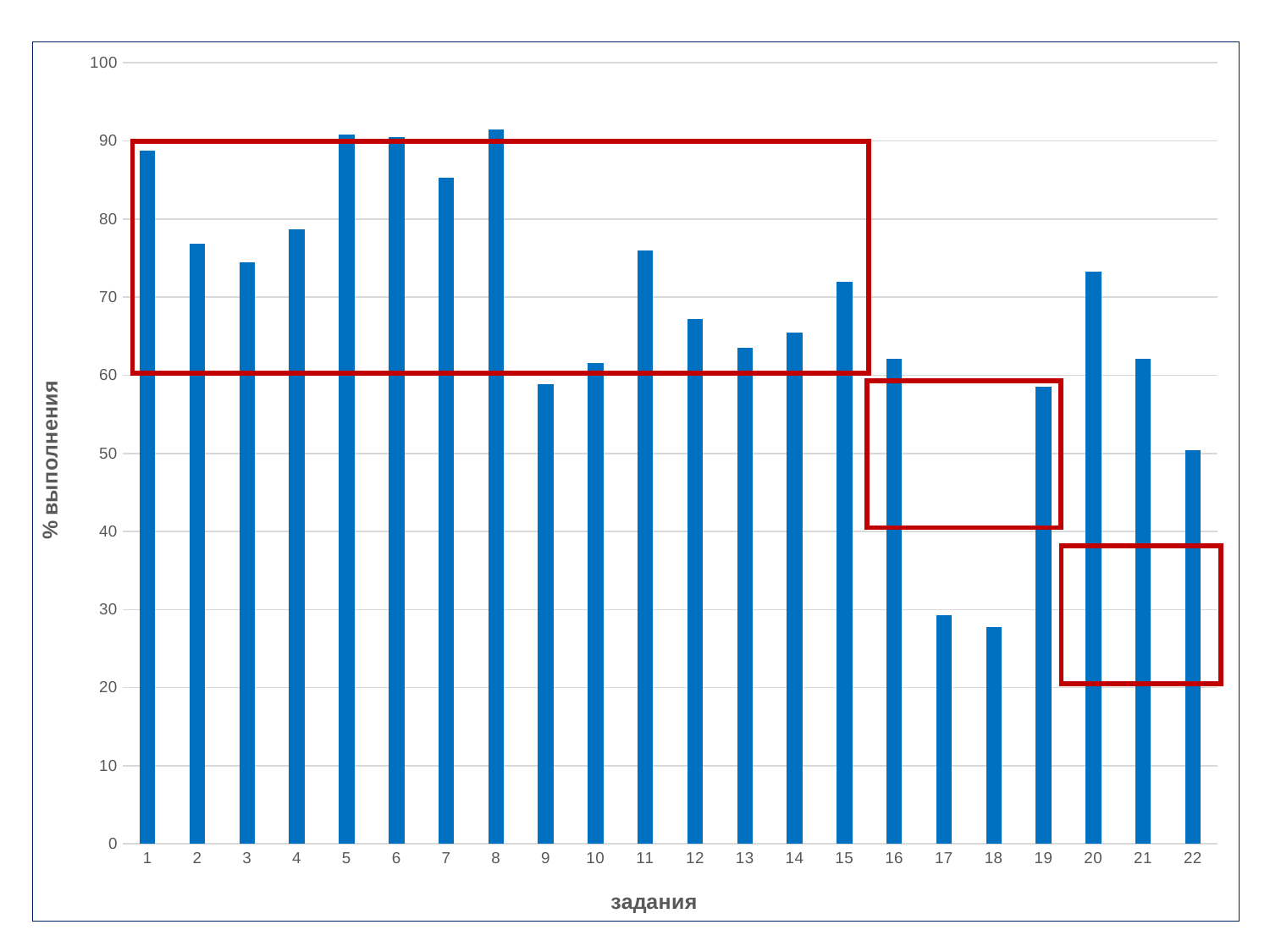
Is the value for task 22 greater or less than 60? less What is the title of the vertical axis? % выполнения How many red rectangles are drawn over the chart? 3 Which has the lower value, task 7 or task 9? task 9 Is the value for task 1 greater or less than 80? greater What kind of chart is shown on the slide? bar chart Which has the higher value, task 17 or task 20? task 20 Which has the higher value, task 1 or task 2? task 1 Is the value for task 17 greater or less than 40? less How many tasks (задания) are plotted along the x axis? 22